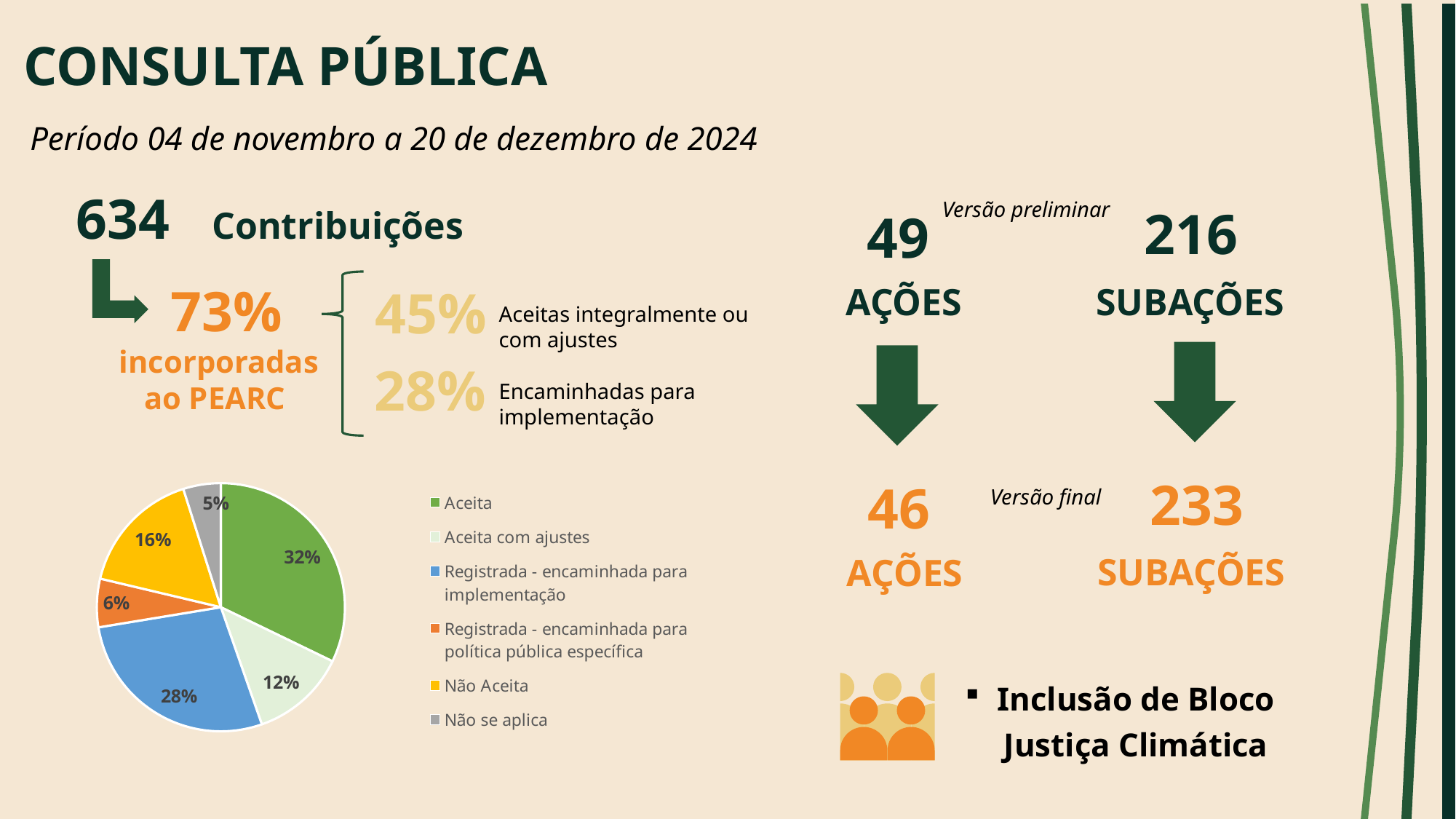
What is the difference between the "Aceita" slice and the "Não Aceita" slice? 16% What colour is the "Não Aceita" slice in the pie chart? yellow Which category has the smallest slice in the pie chart? Não se aplica What share of the pie does "Aceita" represent? 32% Which is larger in the pie chart: "Aceita com ajustes" or "Registrada - encaminhada para política pública específica"? Aceita com ajustes Which category has the largest slice in the pie chart? Aceita What is the value for "Aceita com ajustes" in the pie chart? 12% What is the value for "Não se aplica" in the pie chart? 5% What is the value for "Registrada - encaminhada para implementação" in the pie chart? 28% What is the value for "Não Aceita" in the pie chart? 16% How many categories does the pie chart have? 6 What kind of chart is shown on the slide? pie chart